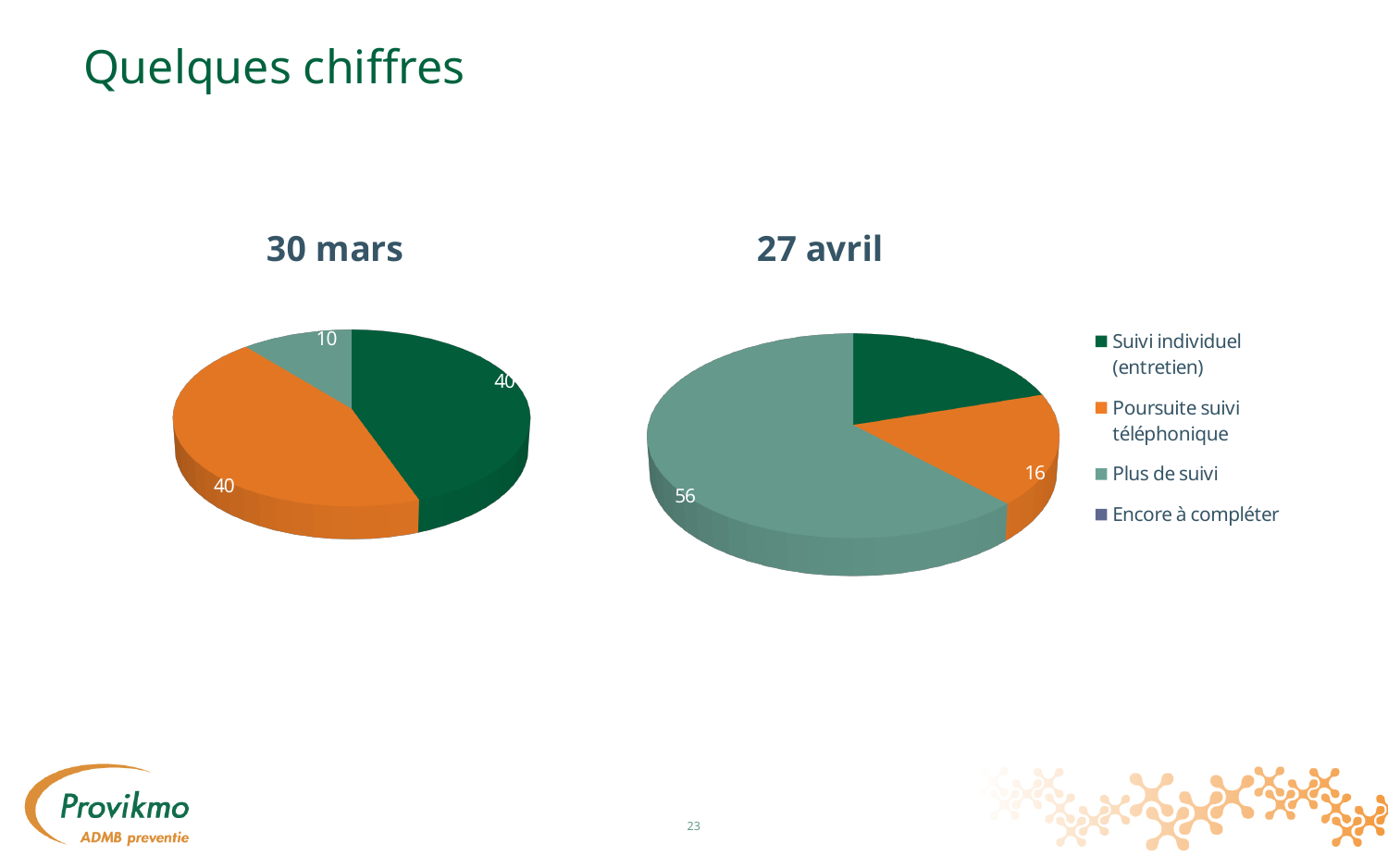
In the 30 mars pie chart, what is the value for Poursuite suivi téléphonique? 40 How many entries does the legend list? 4 In the 27 avril pie chart, which is larger: Plus de suivi or Poursuite suivi téléphonique? Plus de suivi In the 27 avril pie chart, what is the value for Poursuite suivi téléphonique? 16 How many slices does the 30 mars pie chart have? 3 In the 30 mars pie chart, which category has the smallest slice? Plus de suivi In the 27 avril pie chart, what is the difference between the values for Plus de suivi and Poursuite suivi téléphonique? 40 In the 27 avril pie chart, what is the value for Plus de suivi? 56 In the 27 avril pie chart, which category has the largest slice? Plus de suivi In the 30 mars pie chart, what is the value for Plus de suivi? 10 In the 30 mars pie chart, what is the difference between the values for Suivi individuel (entretien) and Plus de suivi? 30 What type of chart is used for the 30 mars and 27 avril data? Pie chart